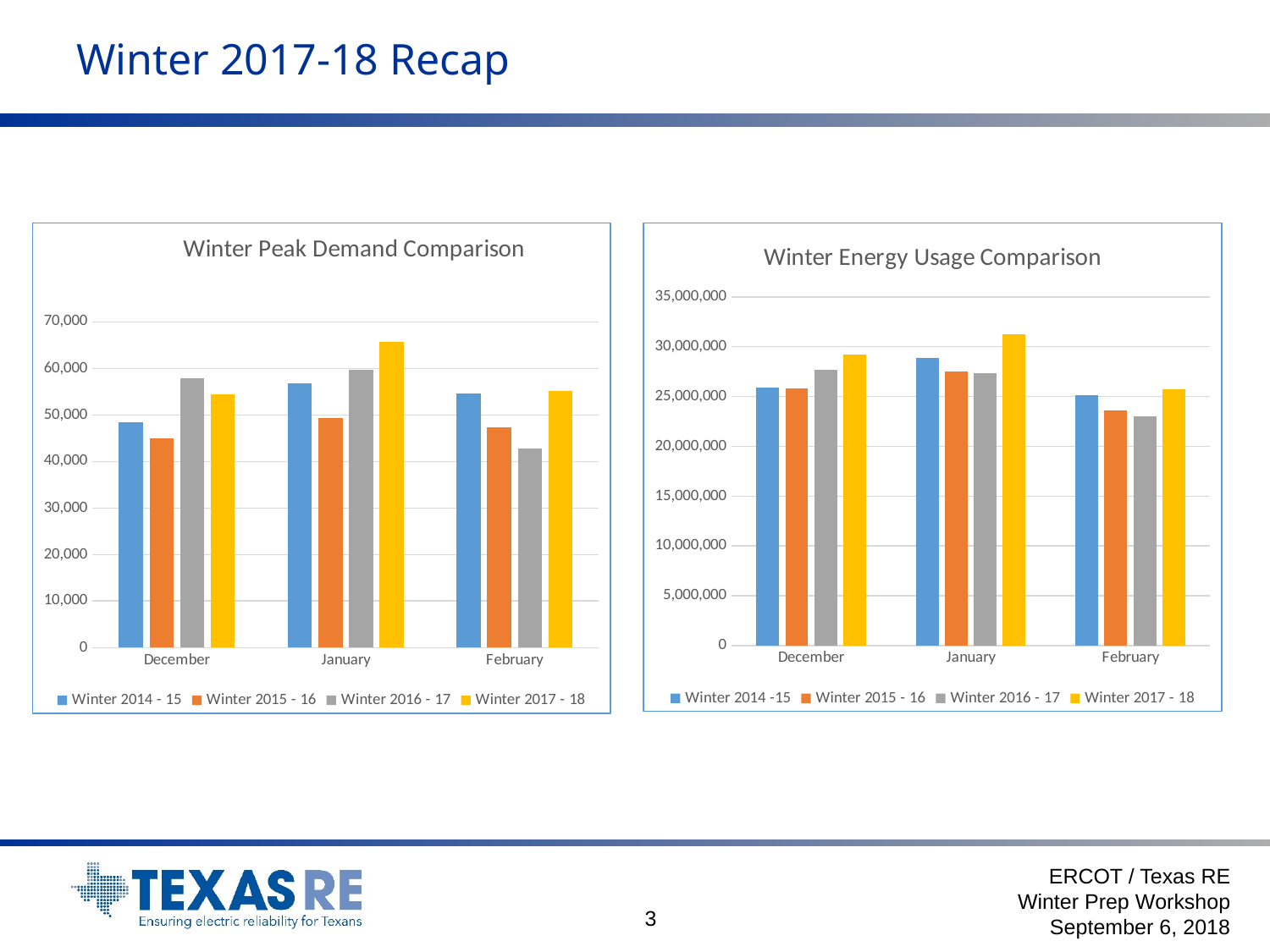
What is the title of the chart on the right side of the slide? Winter Energy Usage Comparison How many series does the legend of the Winter Peak Demand Comparison chart list? 4 In the Winter Peak Demand Comparison chart, which month has the highest Winter 2017 - 18 bar? January In the Winter Peak Demand Comparison chart, which series has the lowest bar for February? Winter 2016 - 17 In the Winter Energy Usage Comparison chart, for February, which is larger: Winter 2014 -15 or Winter 2016 - 17? Winter 2014 -15 How many month categories are shown on the x axis of the Winter Energy Usage Comparison chart? 3 In the Winter Peak Demand Comparison chart, is the Winter 2017 - 18 value for January greater or less than 60,000? greater In the Winter Peak Demand Comparison chart, is the Winter 2016 - 17 value for February greater or less than 50,000? less In the Winter Energy Usage Comparison chart, which series has the highest bar for January? Winter 2017 - 18 In the Winter Peak Demand Comparison chart, for December, which is larger: Winter 2016 - 17 or Winter 2015 - 16? Winter 2016 - 17 In the Winter Energy Usage Comparison chart, is the Winter 2017 - 18 value for January greater or less than 30,000,000? greater What kind of chart is the Winter Peak Demand Comparison chart on the left? bar chart